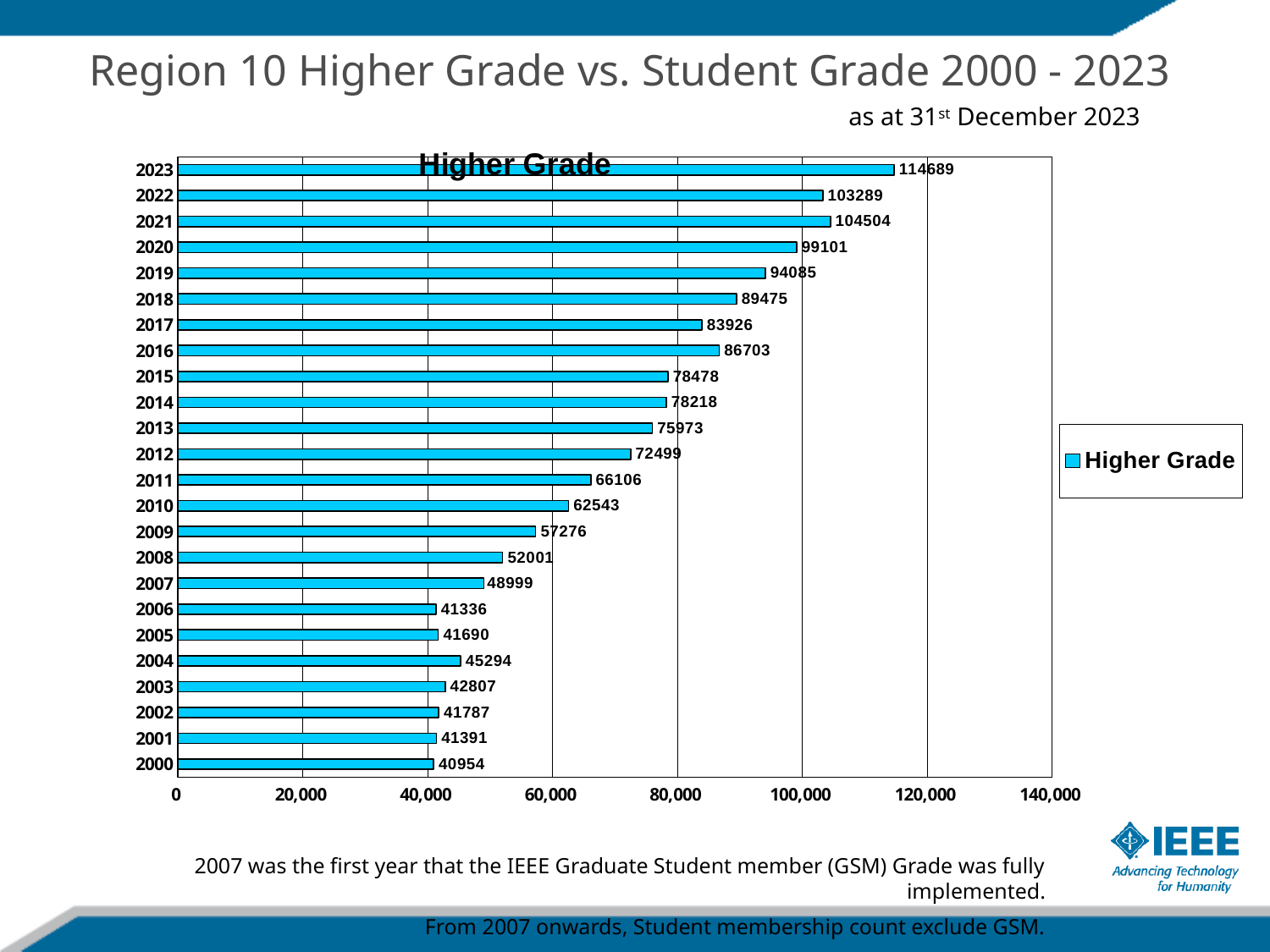
What is the Higher Grade value for 2007? 48999 What is the title of the chart? Higher Grade Which year has the larger Higher Grade value, 2016 or 2017? 2016 Which year has the lowest Higher Grade value? 2000 How many years are shown in the chart? 24 How many series does the legend list? 1 What is the Higher Grade value for 2010? 62543 What is the Higher Grade value for 2023? 114689 What is the difference between the Higher Grade values for 2023 and 2022? 11400 Is the Higher Grade value for 2020 greater or less than 100,000? less Which year has the highest Higher Grade value? 2023 What kind of chart is shown on the slide? bar chart